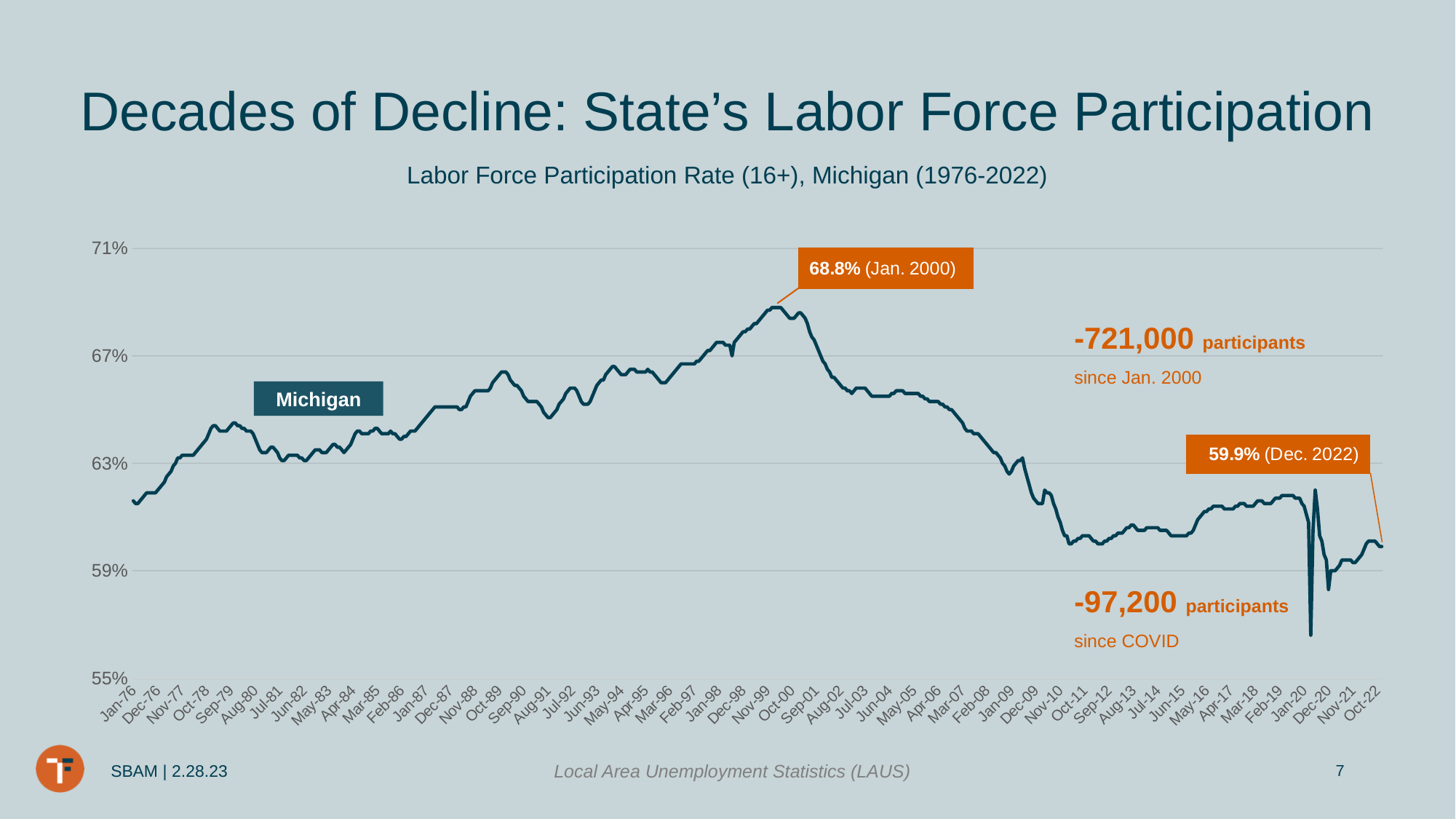
What is the title of the chart? Labor Force Participation Rate (16+), Michigan (1976-2022) By how many percentage points did the labor force participation rate fall from Jan. 2000 to Dec. 2022? 8.9 percentage points Is the participation rate around Nov-10 greater or less than 63%? less When did the labor force participation rate reach its peak on the chart? Jan. 2000 Is the participation rate around Oct-89 greater or less than 63%? greater What was Michigan's labor force participation rate in Dec. 2022? 59.9% How many participants has Michigan's labor force lost since Jan. 2000, according to the slide? -721,000 What was Michigan's labor force participation rate in Jan. 2000? 68.8% Does the participation rate rise or fall overall from Jan. 2000 to Dec. 2022? fall What kind of chart is shown on the slide? line chart Which is higher, the participation rate in Jan. 2000 or in Dec. 2022? Jan. 2000 Is the participation rate at Jan-76 greater or less than 63%? less